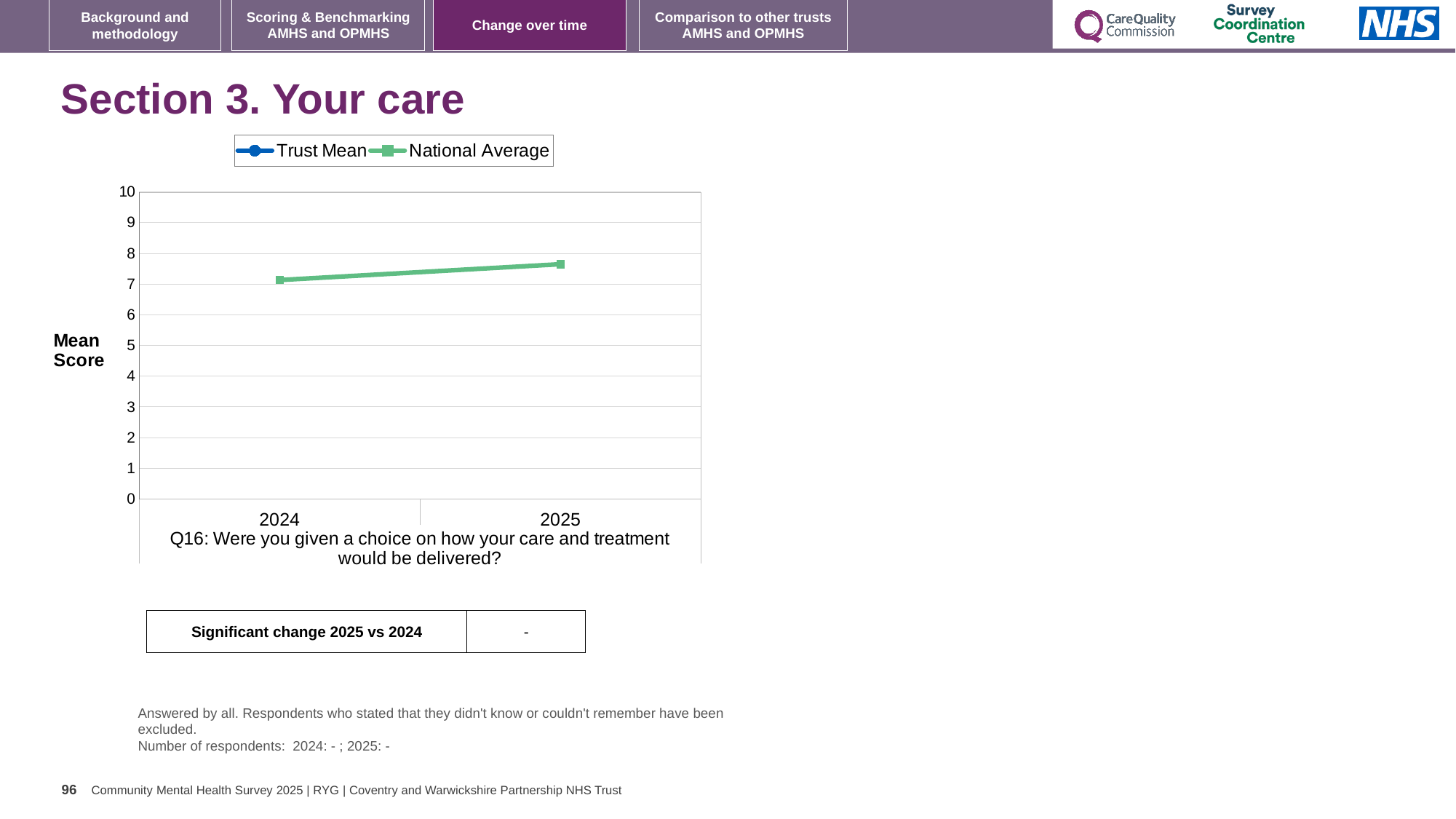
Which year has the higher National Average value, 2024 or 2025? 2025 What kind of chart is shown on the slide? line chart Is the National Average value for 2025 greater or less than 8? less What is the highest value shown on the y axis? 10 How many years are shown on the x axis? 2 Does the National Average line rise or fall from 2024 to 2025? rise Is the National Average value for 2024 greater or less than 8? less How many series does the legend list? 2 Which series in the legend is shown in green? National Average Is the National Average value for 2024 greater or less than 6? greater What is the label on the y axis of the chart? Mean Score